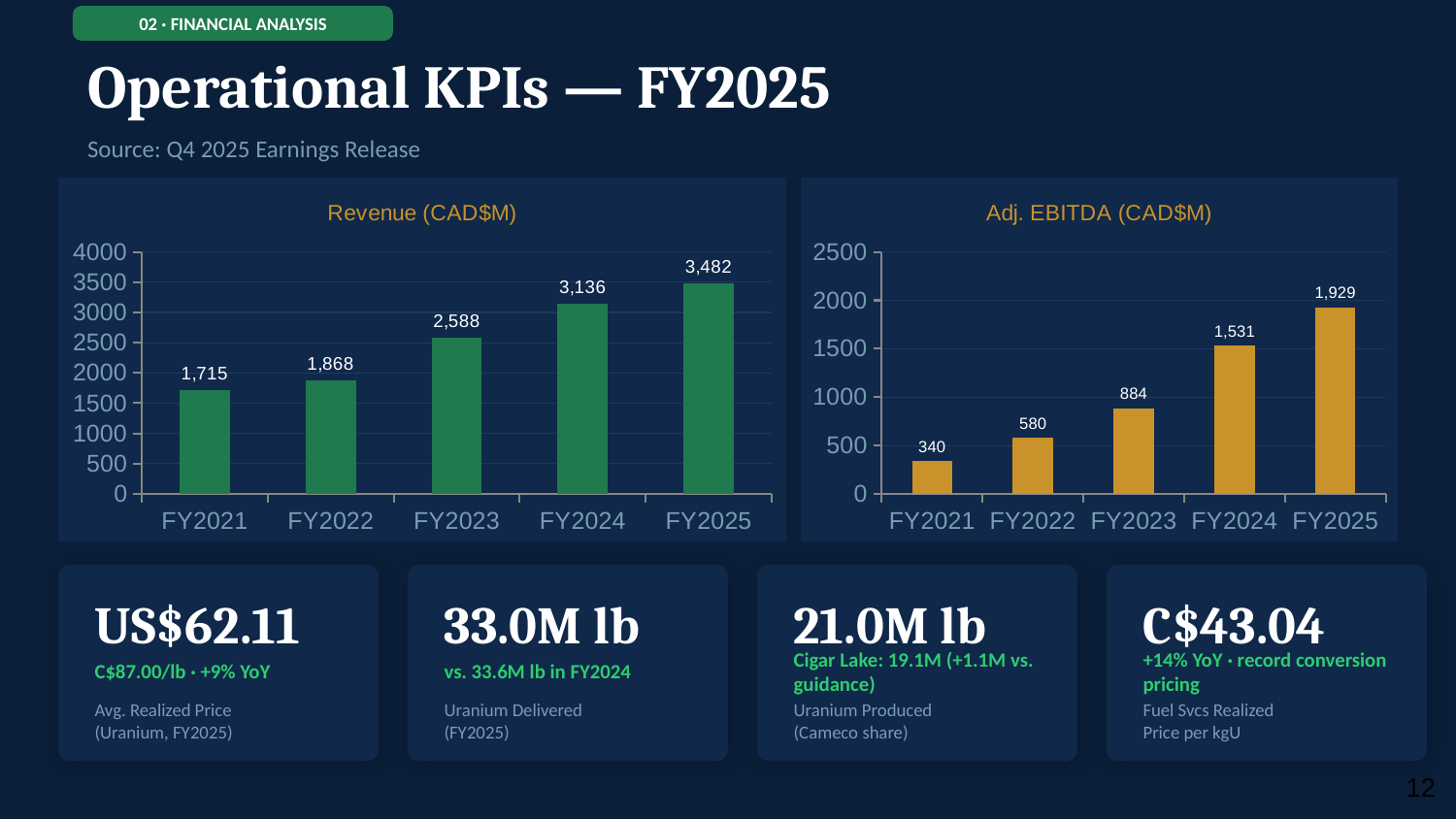
In the Revenue (CAD$M) chart, is the value for FY2024 greater or less than 3000? greater How many years are shown in the Adj. EBITDA (CAD$M) chart? 5 In the Adj. EBITDA (CAD$M) chart, what is the value for FY2022? 580 In the Revenue (CAD$M) chart, what is the value for FY2023? 2,588 What kind of chart is the Revenue (CAD$M) chart? Bar chart In the Revenue (CAD$M) chart, which year has the highest value? FY2025 In the Adj. EBITDA (CAD$M) chart, what is the difference between FY2024 and FY2023? 647 In the Adj. EBITDA (CAD$M) chart, do the values rise or fall from FY2021 to FY2025? Rise In the Adj. EBITDA (CAD$M) chart, which is larger, FY2023 or FY2022? FY2023 What colour are the bars in the Adj. EBITDA (CAD$M) chart? Gold In the Adj. EBITDA (CAD$M) chart, which year has the lowest value? FY2021 In the Revenue (CAD$M) chart, what is the difference between FY2025 and FY2024? 346